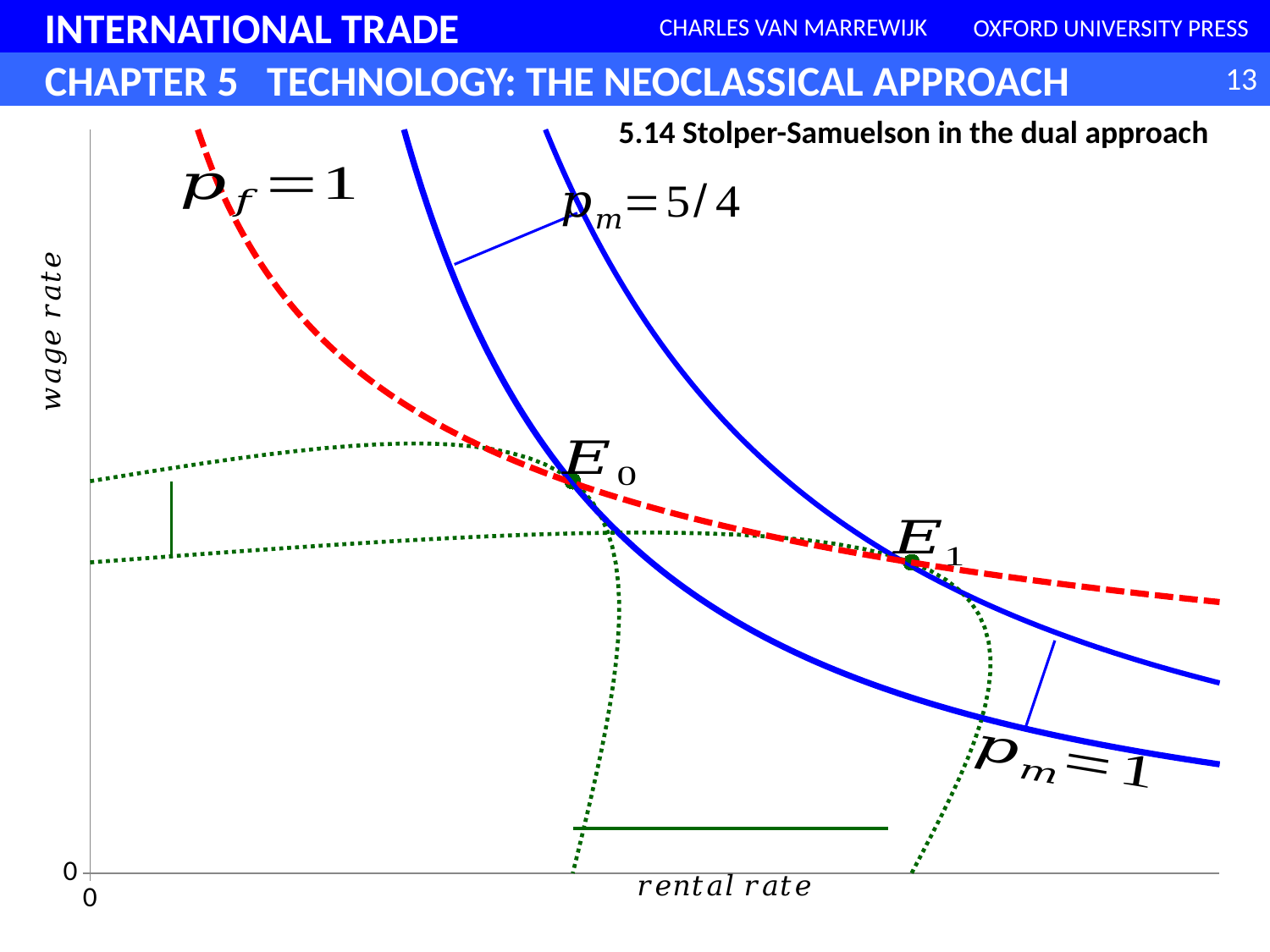
What is the title of the chart on the slide? 5.14 Stolper-Samuelson in the dual approach What value is printed at the origin of the axes? 0 Which of the two blue curves lies further from the origin, p_m = 1 or p_m = 5/4? p_m = 5/4 How many solid blue curves are drawn on the chart? 2 What label is on the horizontal axis of the chart? rental rate Does the wage rate along the p_m = 1 curve rise or fall as the rental rate increases? fall Which curve passes through both E0 and E1? p_f = 1 What label is on the vertical axis of the chart? wage rate Which labelled point, E0 or E1, has the higher rental rate? E1 Which labelled point, E0 or E1, has the higher wage rate? E0 Does the wage rate along the p_f = 1 curve rise or fall as the rental rate increases? fall How many labelled equilibrium points (E) are marked on the chart? 2